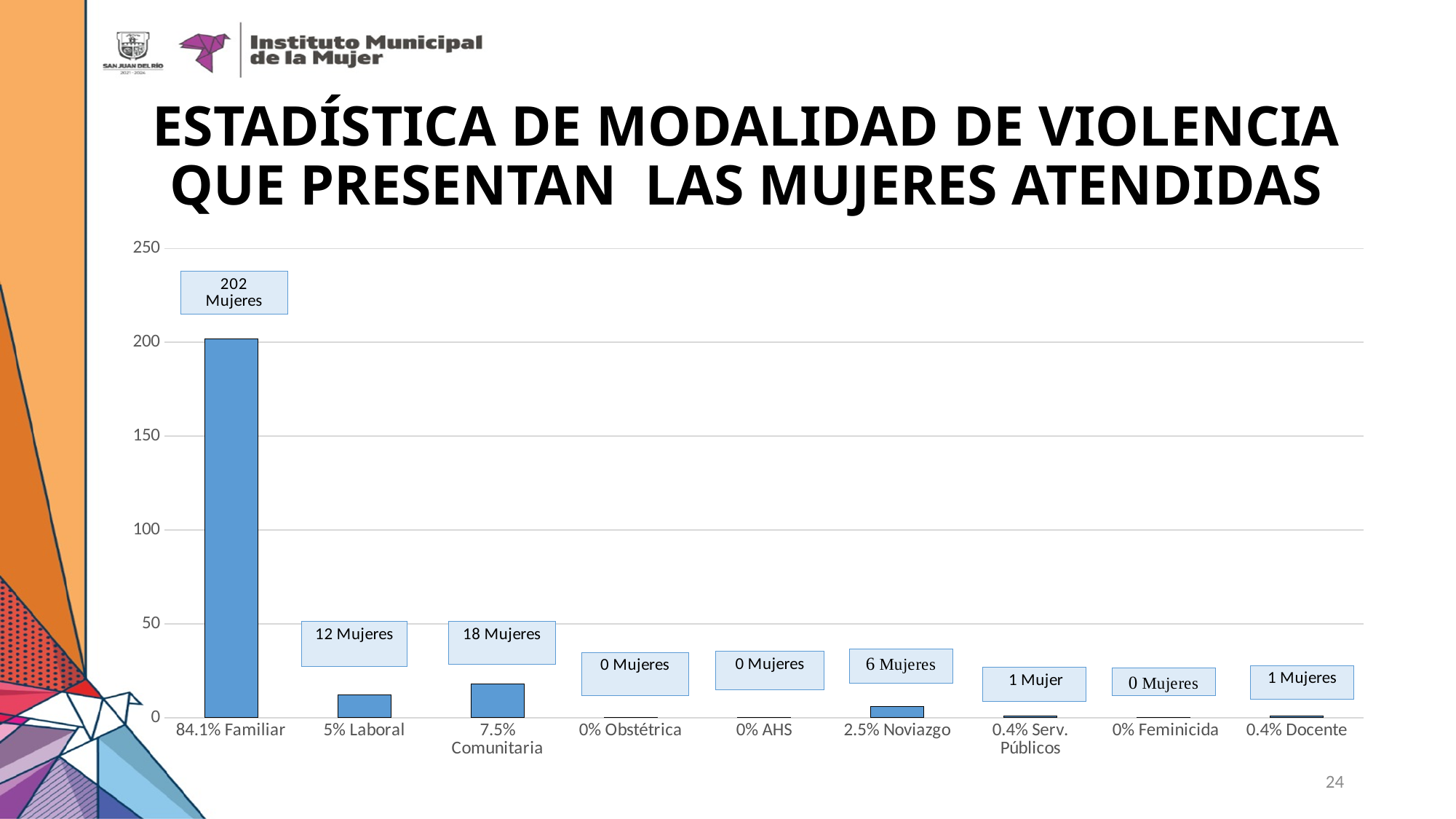
What is the data label on the bar for Familiar? 202 Mujeres What is the title of the slide containing the chart? ESTADÍSTICA DE MODALIDAD DE VIOLENCIA QUE PRESENTAN LAS MUJERES ATENDIDAS What is the data label on the bar for Comunitaria? 18 Mujeres Which category has the highest bar in the chart? Familiar What percentage is shown in the x-axis label for Familiar? 84.1% How many categories (modalities of violence) are shown on the x axis of the chart? 9 Which is larger, the value for Laboral or the value for Comunitaria? Comunitaria What is the data label on the bar for Laboral? 12 Mujeres Is the value for Familiar greater or less than 200? greater What kind of chart is shown on the slide? Bar chart What is the data label on the bar for Noviazgo? 6 Mujeres What is the difference in number of women between Comunitaria and Laboral? 6